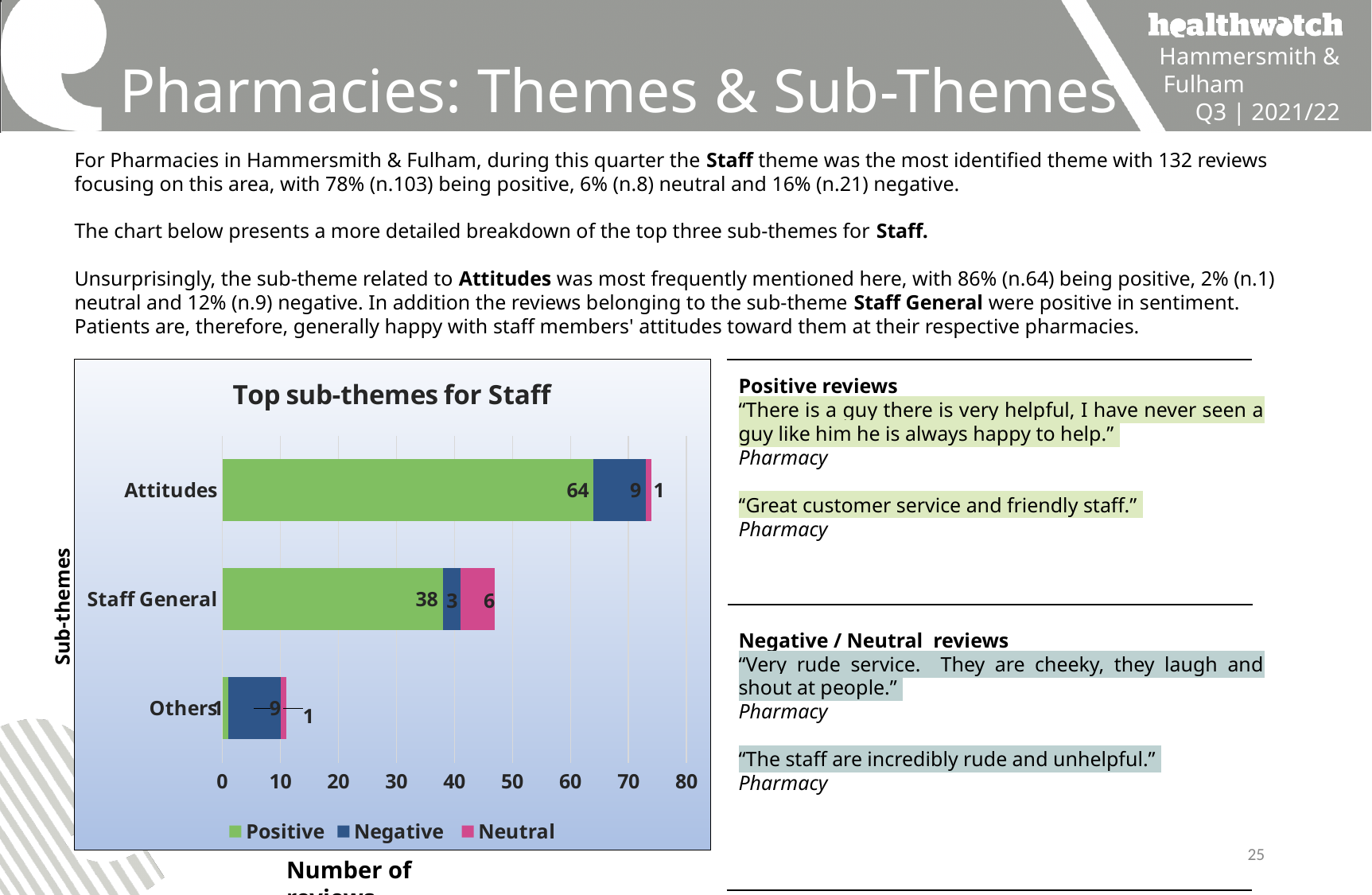
In 'Top sub-themes for Staff', what is the total number of reviews for Attitudes across all three series? 74 In 'Top sub-themes for Staff', what is the difference between the Positive reviews for Attitudes and for Staff General? 26 What type of chart is 'Top sub-themes for Staff'? Stacked bar chart In 'Top sub-themes for Staff', how many Neutral reviews does Staff General have? 6 In 'Top sub-themes for Staff', how many Negative reviews does Staff General have? 3 In 'Top sub-themes for Staff', how many Negative reviews does Others have? 9 Which sub-theme has the highest number of Positive reviews in 'Top sub-themes for Staff'? Attitudes Which sub-theme has the lowest number of Positive reviews in 'Top sub-themes for Staff'? Others In 'Top sub-themes for Staff', which is larger: the Neutral reviews for Staff General or the Neutral reviews for Attitudes? Staff General How many sub-themes are shown in 'Top sub-themes for Staff'? 3 In 'Top sub-themes for Staff', how many Positive reviews does Attitudes have? 64 How many series does the legend of 'Top sub-themes for Staff' list? 3